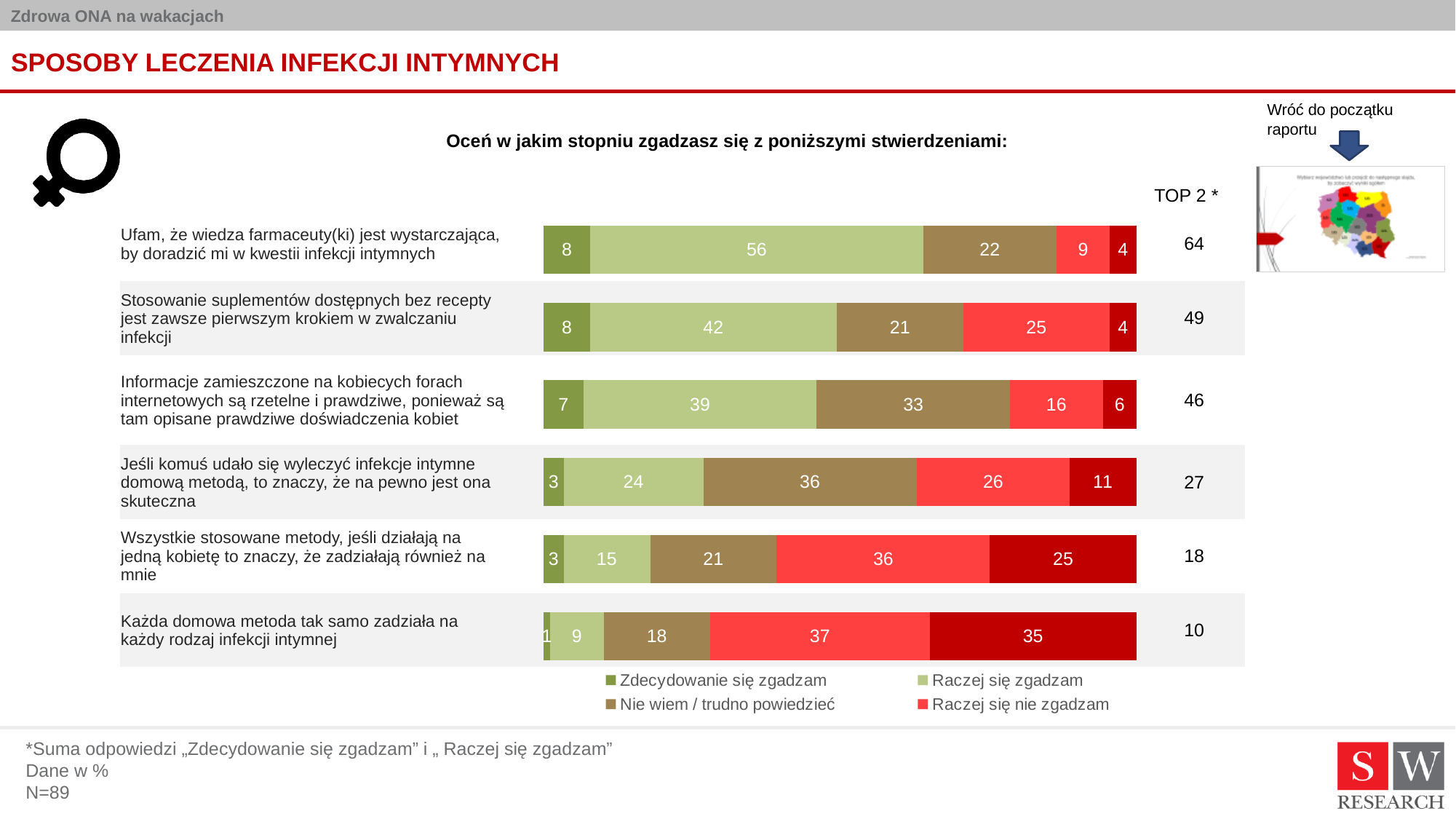
What is the difference between the TOP 2 value for "Ufam, że wiedza farmaceuty(ki)..." and the TOP 2 value for "Stosowanie suplementów dostępnych bez recepty..."? 15 Which statement has the lowest TOP 2 value? Każda domowa metoda tak samo zadziała na każdy rodzaj infekcji intymnej How many entries does the chart legend list? 4 How many statements are shown in the chart? 6 What is the "Nie wiem / trudno powiedzieć" value for the statement "Informacje zamieszczone na kobiecych forach internetowych są rzetelne i prawdziwe..."? 33 What is the sample size (N) stated on the slide? N=89 What kind of chart is shown on the slide? Stacked bar chart Which statement has the highest TOP 2 value? Ufam, że wiedza farmaceuty(ki) jest wystarczająca, by doradzić mi w kwestii infekcji intymnych What is the total of all segments in the bar for "Stosowanie suplementów dostępnych bez recepty jest zawsze pierwszym krokiem w zwalczaniu infekcji"? 100 What is the "Raczej się nie zgadzam" value for the statement "Każda domowa metoda tak samo zadziała na każdy rodzaj infekcji intymnej"? 37 What percentage of respondents answered "Raczej się zgadzam" to the statement "Ufam, że wiedza farmaceuty(ki) jest wystarczająca, by doradzić mi w kwestii infekcji intymnych"? 56 Which statement has the larger "Nie wiem / trudno powiedzieć" value: "Jeśli komuś udało się wyleczyć infekcje intymne domową metodą..." or "Wszystkie stosowane metody, jeśli działają na jedną kobietę..."? Jeśli komuś udało się wyleczyć infekcje intymne domową metodą, to znaczy, że na pewno jest ona skuteczna